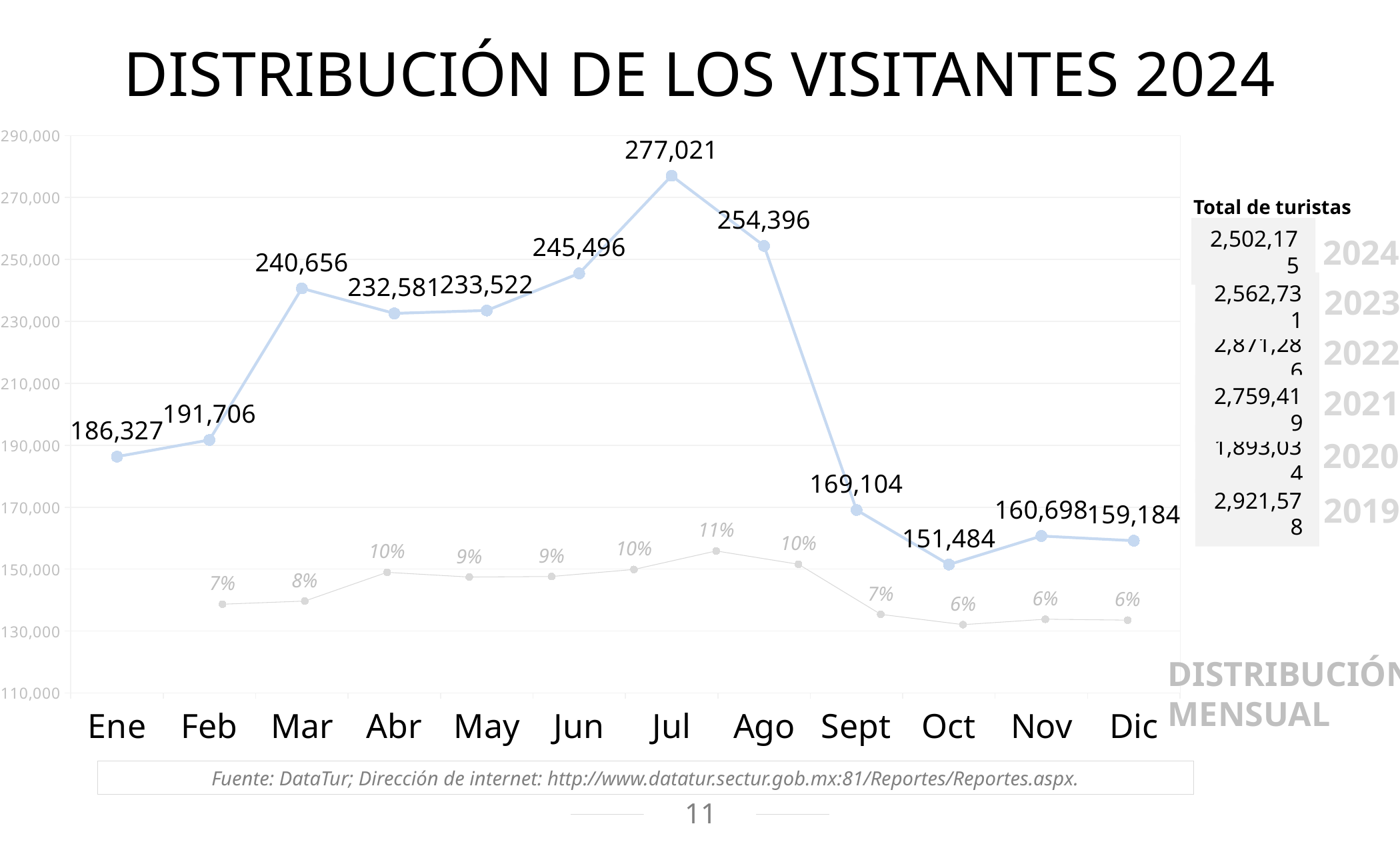
What is the difference between the visitors in Jul and Ago? 22,625 How many months are plotted on the x axis? 12 What is the difference between the visitors in Mar and Feb? 48,950 Which month has the lowest number of visitors? Oct What type of chart is shown on the slide? line chart What is the number of visitors in Ene? 186,327 What percentage is labelled on the grey line for Jul? 11% Which month has the highest number of visitors? Jul Which month has more visitors, Nov or Dic? Nov What is the number of visitors in Jul? 277,021 Do the visitor numbers rise or fall from Jul to Oct? fall What is the number of visitors in Oct? 151,484